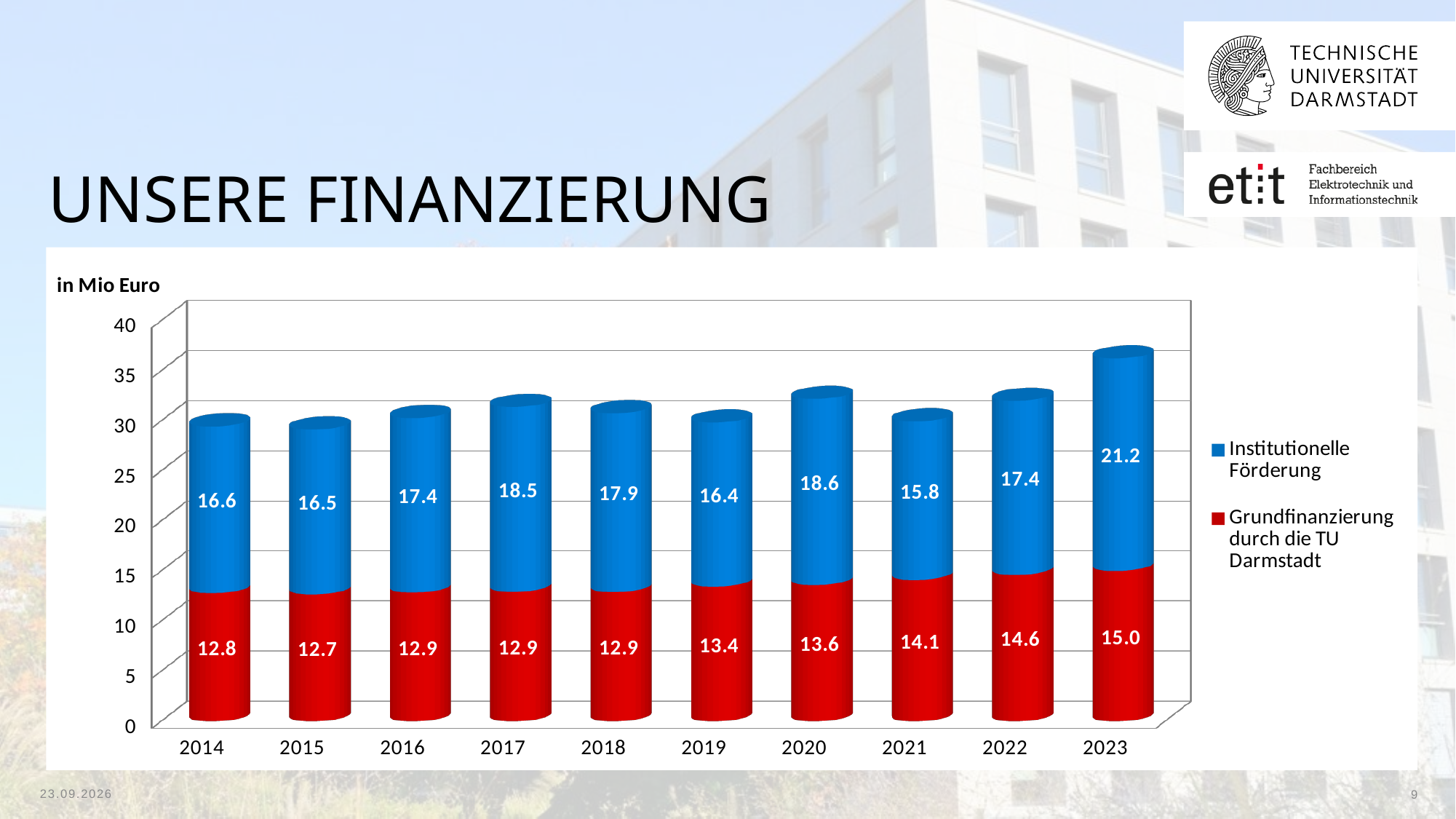
Is Institutionelle Förderung larger in 2017 or in 2019? 2017 Does Grundfinanzierung durch die TU Darmstadt rise or fall from 2019 to 2023? Rise What unit is stated above the chart? in Mio Euro What is the difference between Institutionelle Förderung in 2023 and in 2022? 3.8 How many years are shown on the x axis? 10 What is the total of the stacked bar for 2020? 32.2 What is the value of Institutionelle Förderung in 2023? 21.2 Which year has the highest value for Institutionelle Förderung? 2023 Which year has the lowest value for Grundfinanzierung durch die TU Darmstadt? 2015 How many series does the legend list? 2 What kind of chart is shown on the slide? Stacked bar chart What is the value of Grundfinanzierung durch die TU Darmstadt in 2014? 12.8